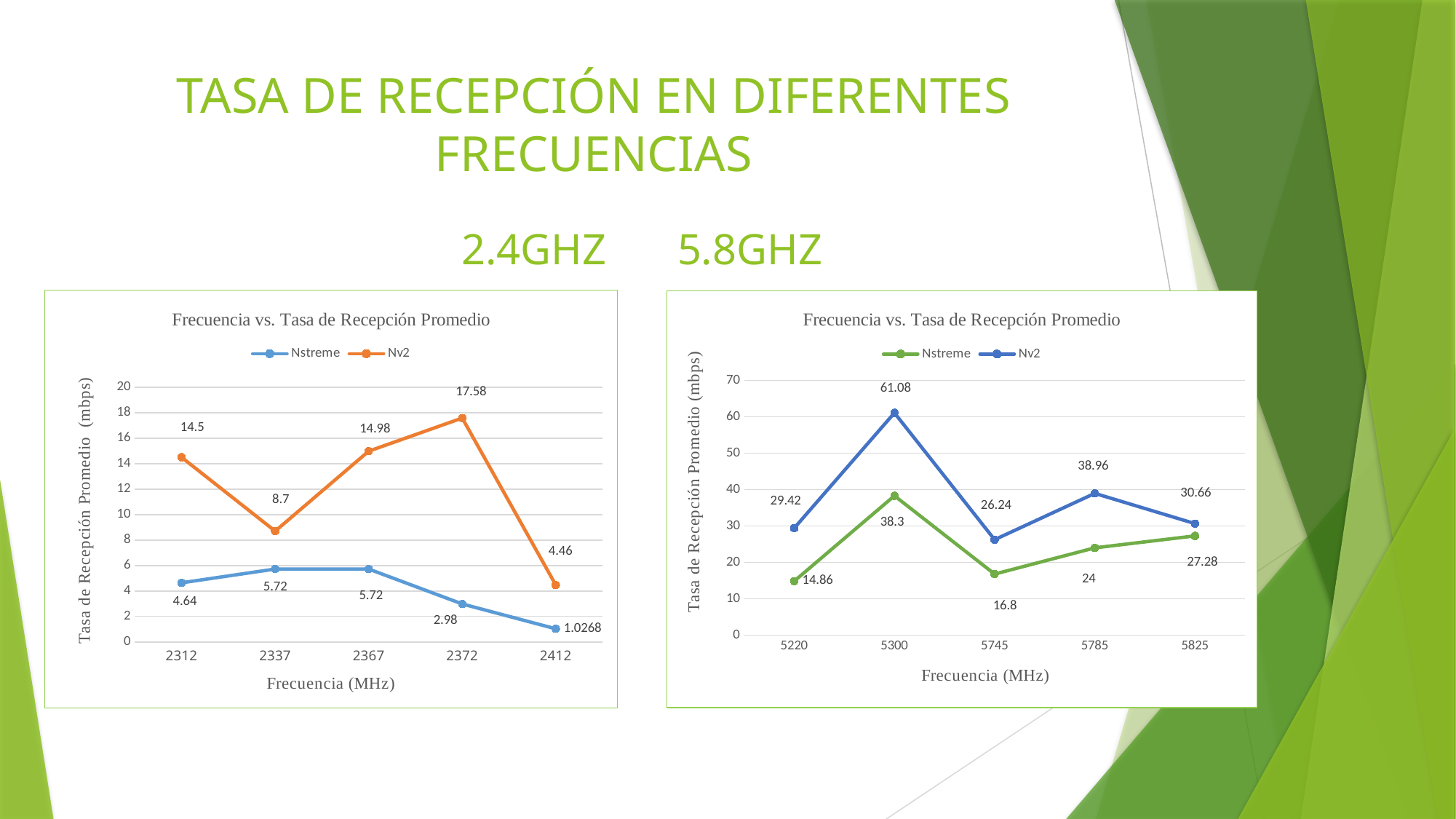
In the 2.4GHZ chart (left), which series has the larger value at 2337 MHz, Nstreme or Nv2? Nv2 How many frequency points are plotted in the 2.4GHZ chart (left)? 5 In the 2.4GHZ chart (left), what is the Nv2 value at 2372 MHz? 17.58 In the 5.8GHZ chart (right), what is the Nstreme value at 5785 MHz? 24 How many series does the legend of the 5.8GHZ chart (right) list? 2 In the 5.8GHZ chart (right), at which frequency is the Nstreme value lowest? 5220 In the 2.4GHZ chart (left), at which frequency does Nv2 reach its highest value? 2372 In the 2.4GHZ chart (left), what is the Nstreme value at 2412 MHz? 1.0268 What type of chart is the 2.4GHZ chart (left)? Line chart In the 5.8GHZ chart (right), what is the Nv2 value at 5300 MHz? 61.08 In the 5.8GHZ chart (right), what is the difference between the Nv2 and Nstreme values at 5300 MHz? 22.78 In the 5.8GHZ chart (right), is the Nv2 value at 5745 MHz greater or less than 30? less